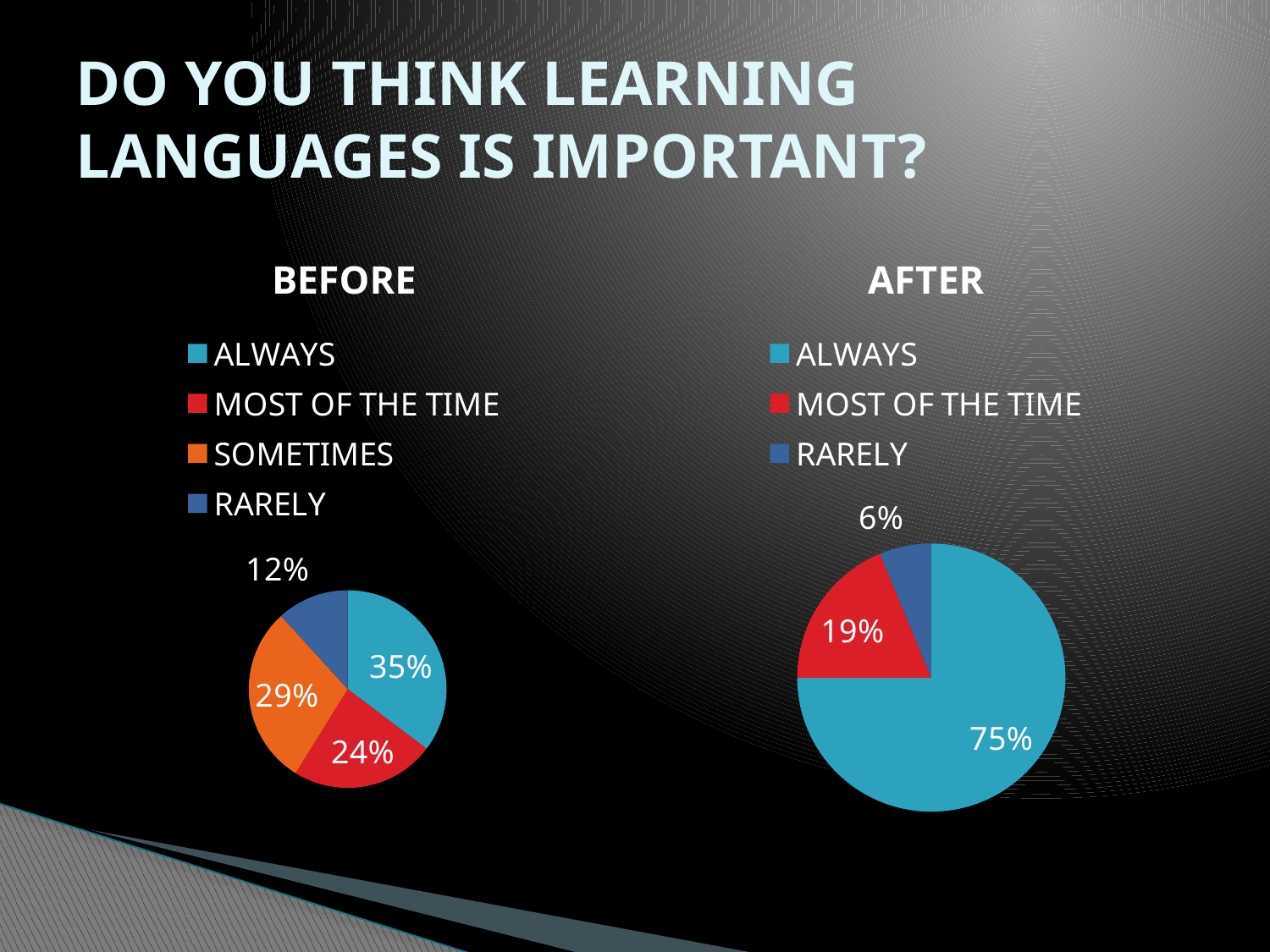
What type of chart is the AFTER chart? Pie chart In the BEFORE pie chart, what is the difference between the ALWAYS and MOST OF THE TIME percentages? 11% In the AFTER pie chart, what is the difference between the ALWAYS and MOST OF THE TIME percentages? 56% In the BEFORE pie chart, what percentage is shown for ALWAYS? 35% In the BEFORE pie chart, which is larger: SOMETIMES or MOST OF THE TIME? SOMETIMES In the AFTER pie chart, which category has the largest slice? ALWAYS In the AFTER pie chart, what percentage is shown for RARELY? 6% How many categories does the legend of the BEFORE chart list? 4 In the BEFORE pie chart, which category has the smallest slice? RARELY In the BEFORE pie chart, what percentage is shown for SOMETIMES? 29% In the AFTER pie chart, what percentage is shown for MOST OF THE TIME? 19% How many categories does the legend of the AFTER chart list? 3